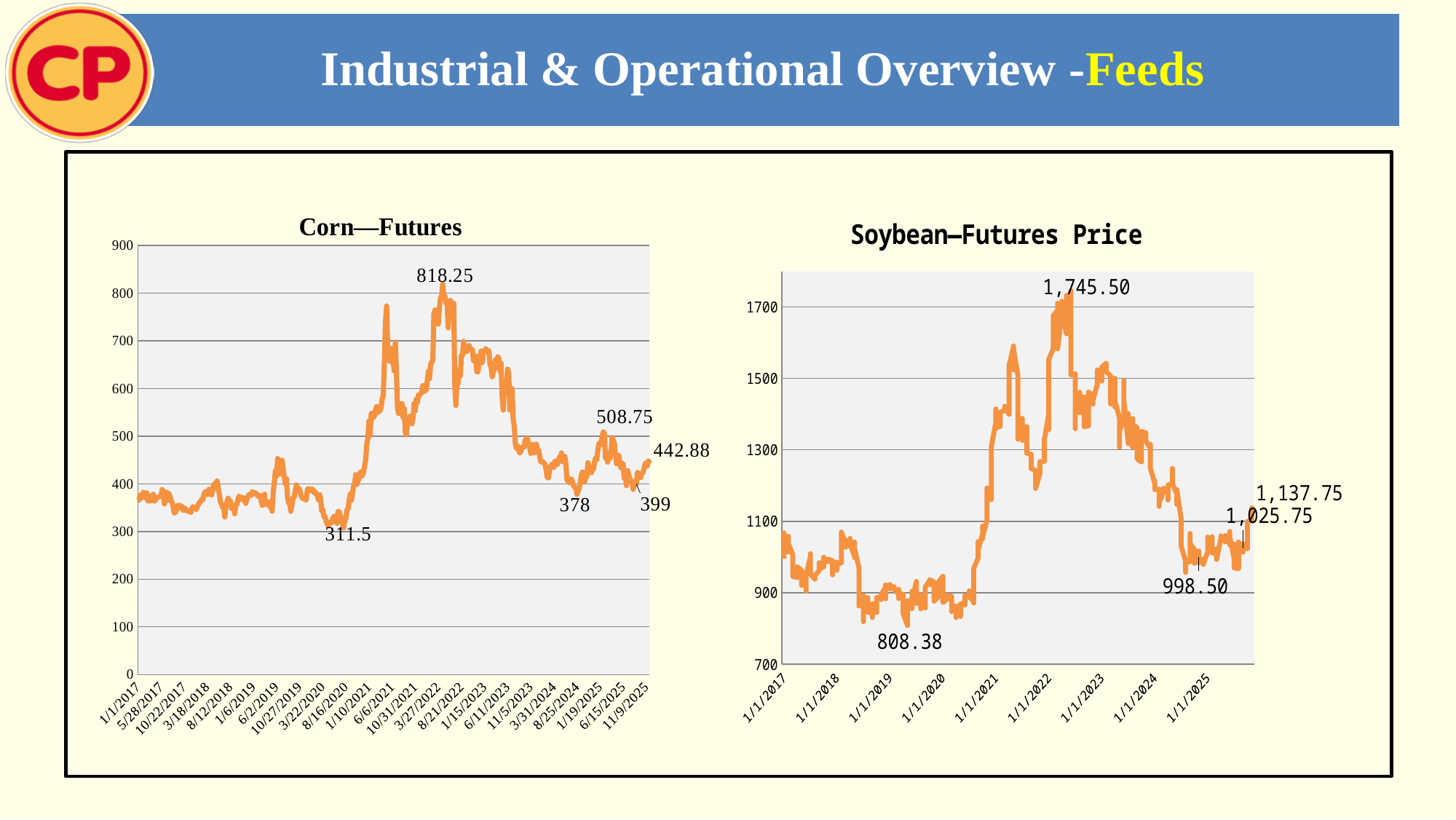
On the Corn—Futures chart, what is the difference between the peak label 818.25 and the low label 311.5? 506.75 On the Corn—Futures chart, which labeled value is larger, 508.75 or 399? 508.75 On the Soybean—Futures Price chart, is the value at 1/1/2019 greater or less than 1100? less What kind of chart is the Corn—Futures chart? line chart On the Soybean—Futures Price chart, what is the difference between the peak label 1,745.50 and the low label 808.38? 937.12 On the Soybean—Futures Price chart, what is the highest labeled value? 1,745.50 On the Corn—Futures chart, is the value at 1/1/2017 greater or less than 500? less On the Corn—Futures chart, what is the last labeled value at the right end of the line? 442.88 What is the title of the chart on the right side of the slide? Soybean—Futures Price On the Corn—Futures chart, what is the lowest labeled value? 311.5 On the Soybean—Futures Price chart, what is the lowest labeled value? 808.38 On the Corn—Futures chart, what is the highest labeled value? 818.25